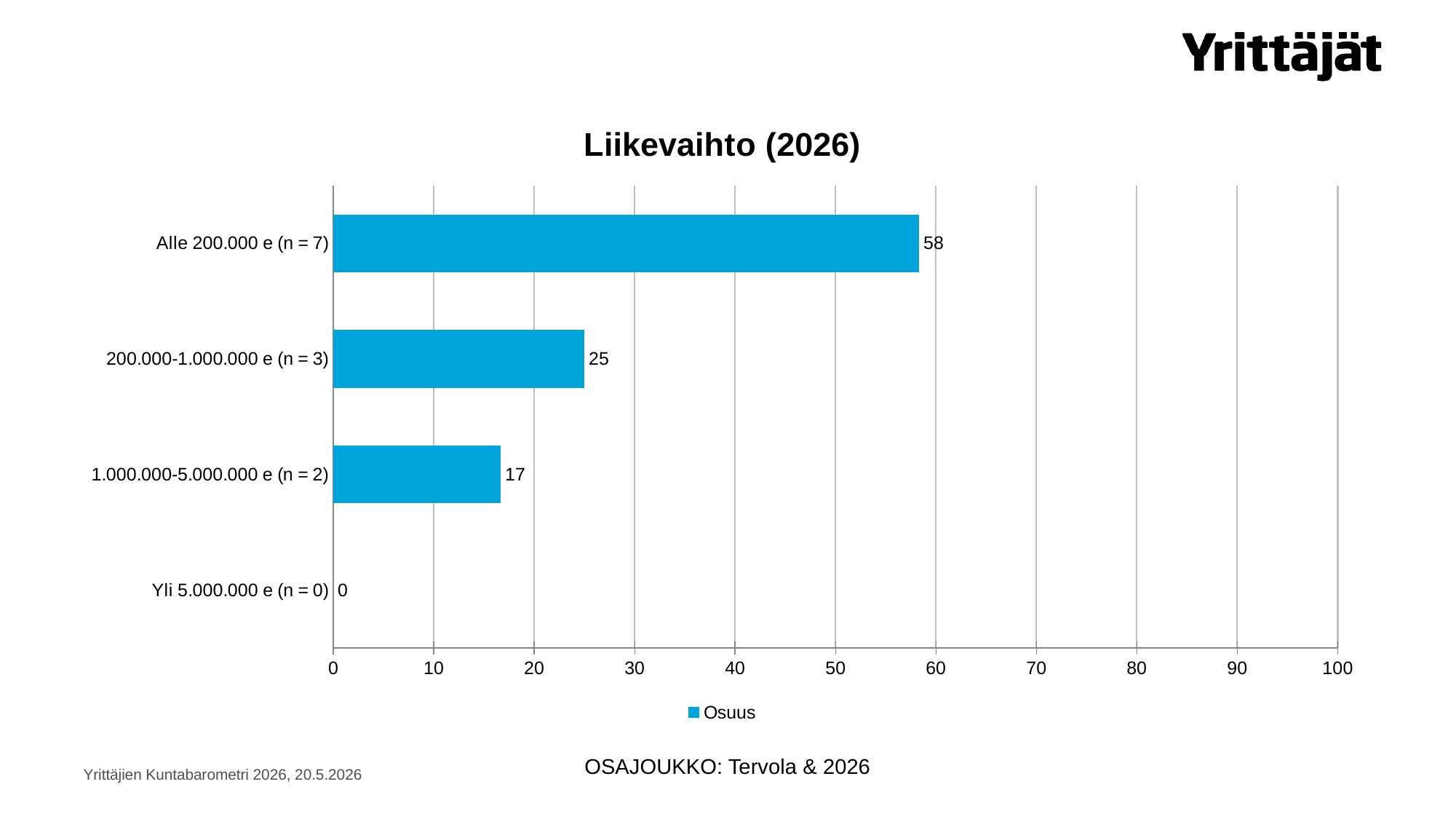
Which category has the lowest value? Yli 5.000.000 e (n = 0) What is the value for 200.000-1.000.000 e (n = 3)? 25 Which is larger, the value for 200.000-1.000.000 e (n = 3) or 1.000.000-5.000.000 e (n = 2)? 200.000-1.000.000 e (n = 3) How many categories are shown in the chart? 4 What is the difference between the values for Alle 200.000 e (n = 7) and 200.000-1.000.000 e (n = 3)? 33 What is the title of the chart? Liikevaihto (2026) What is the value for 1.000.000-5.000.000 e (n = 2)? 17 What is the value for Alle 200.000 e (n = 7)? 58 What kind of chart is shown on the slide? Bar chart Which category has the highest value? Alle 200.000 e (n = 7) What is the value for Yli 5.000.000 e (n = 0)? 0 How many series does the legend list? 1